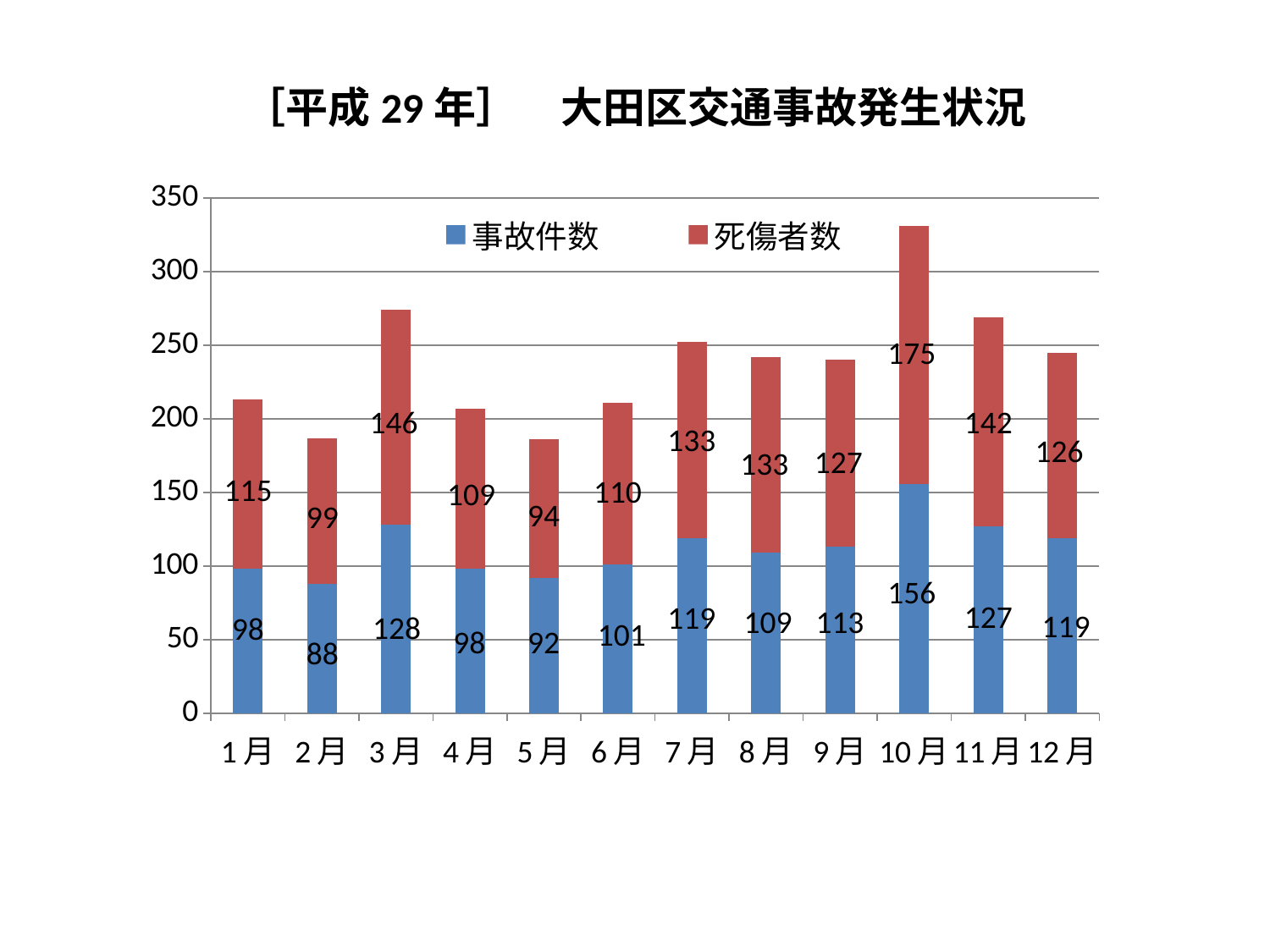
What type of chart is shown on the slide? stacked bar chart Which is larger, 事故件数 in 7月 or 事故件数 in 9月? 7月 What is the value of 死傷者数 for 3月? 146 How many series does the legend list? 2 Which series is shown in blue? 事故件数 What is the value of 事故件数 for 10月? 156 Is the total stacked bar for 10月 greater or less than 300? greater What is the difference between 死傷者数 in 10月 and 死傷者数 in 5月? 81 What is the total of the stacked bar for 1月? 213 Which month has the lowest 事故件数? 2月 How many months are shown on the x axis? 12 Which month has the highest 死傷者数? 10月